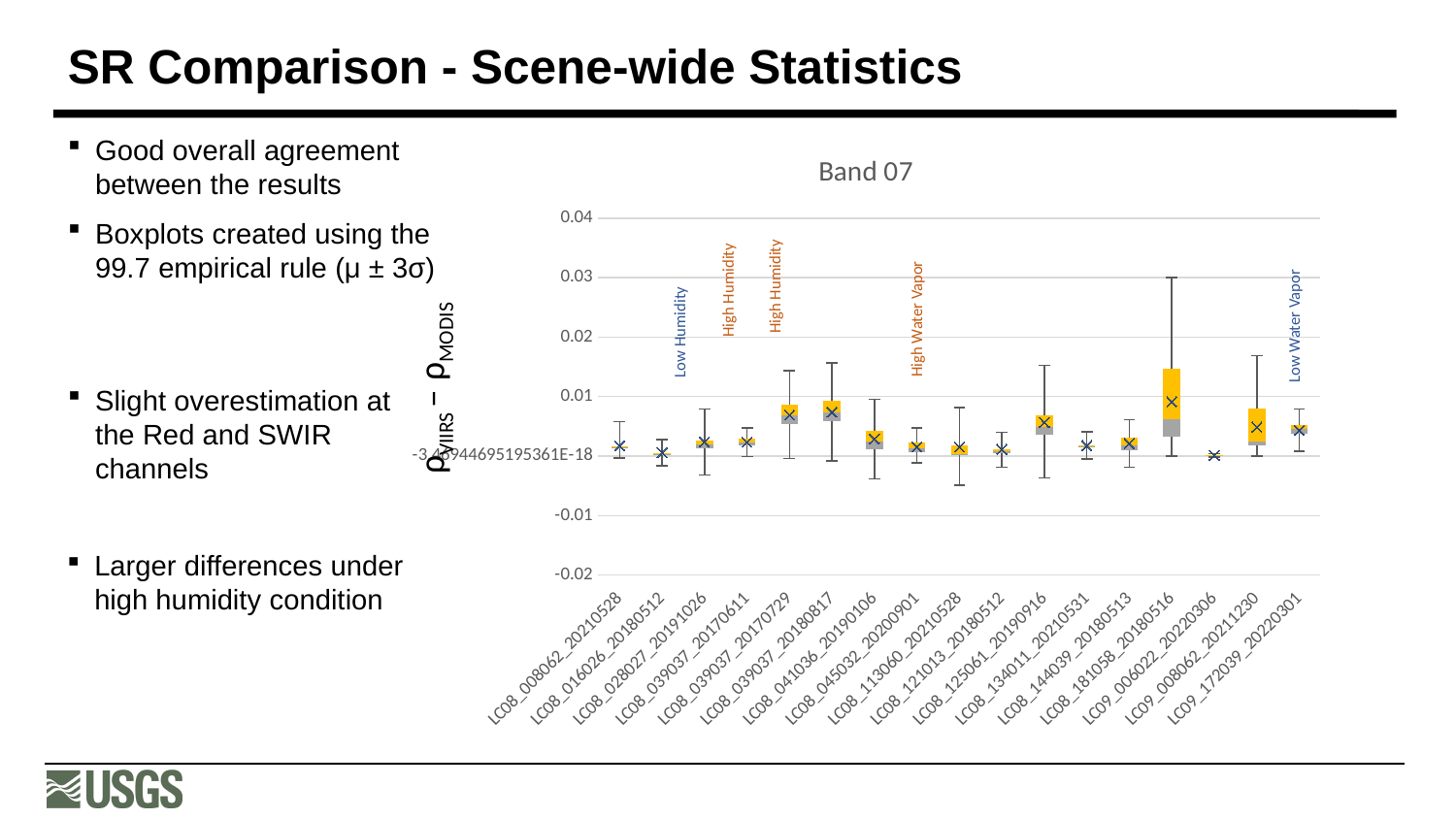
Is the lower whisker for LC08_121013_20180512 greater or less than -0.01? greater Which has the taller box in the Band 07 chart, LC08_181058_20180516 or LC08_016026_20180512? LC08_181058_20180516 Is the upper whisker for LC08_039037_20180817 greater or less than 0.01? greater Is the mean marker for LC09_006022_20220306 greater or less than 0.01? less What is the highest value shown on the y axis of the Band 07 chart? 0.04 Which category in the Band 07 chart has the highest upper whisker? LC08_181058_20180516 How many scene categories are plotted along the x axis of the Band 07 chart? 17 Which has the higher upper whisker, LC09_008062_20211230 or LC08_045032_20200901? LC09_008062_20211230 What is the title of the chart? Band 07 What kind of chart is shown on the slide? Box plot